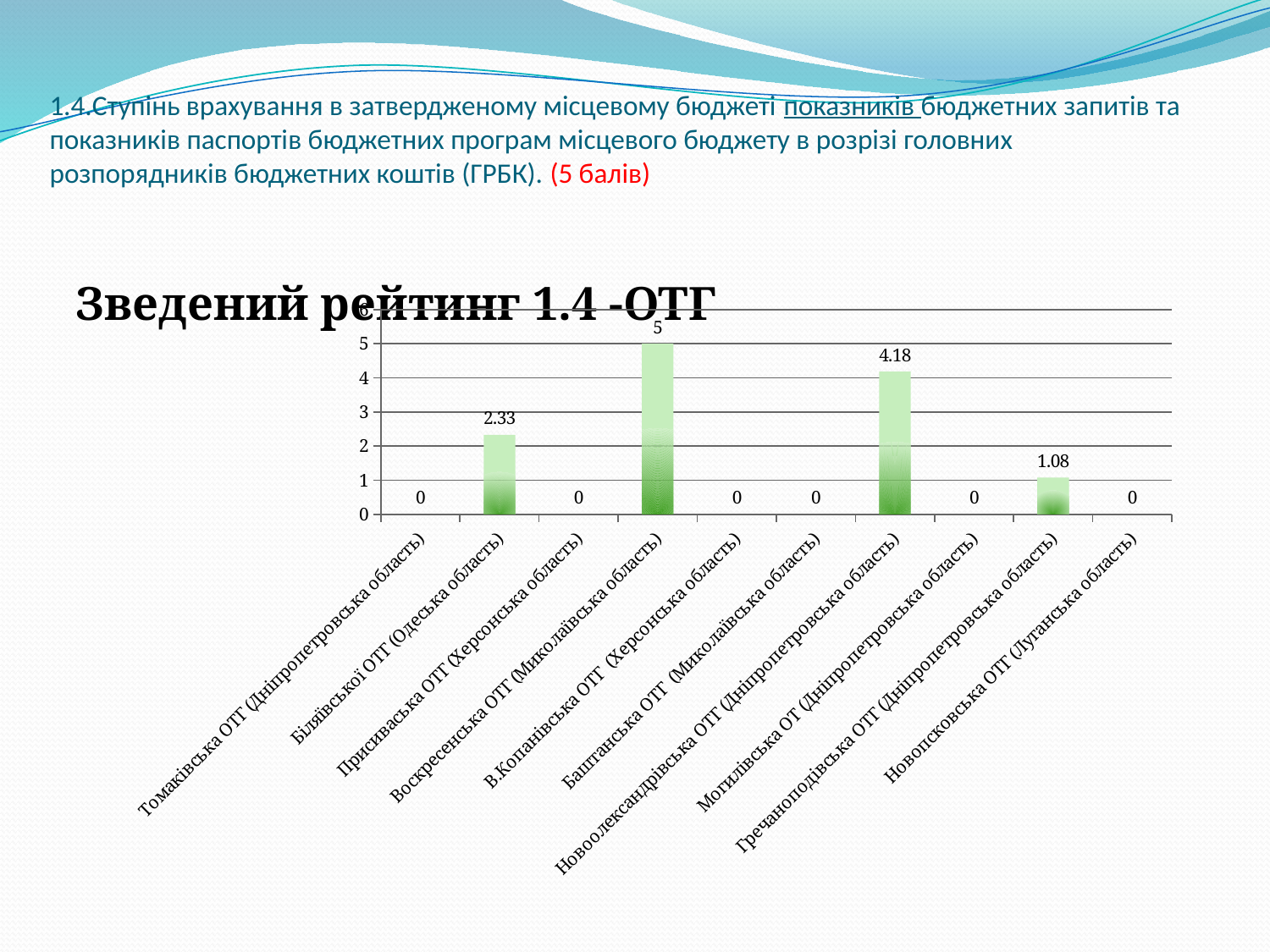
Which category has the highest value on the chart? Воскресенська ОТГ (Миколаївська область) What is the difference between the values for Воскресенська ОТГ and Новоолександрівська ОТГ? 0.82 What is the value for Біляївської ОТГ (Одеська область)? 2.33 What type of chart is shown on the slide? bar chart How many categories (ОТГ) are plotted on the chart? 10 What is the title of the chart? Зведений рейтинг 1.4 -ОТГ How many categories on the chart have a value of 0? 6 What is the value for Томаківська ОТГ (Дніпропетровська область)? 0 Which is larger, the value for Біляївської ОТГ or the value for Гречанопідівська ОТГ? Біляївської ОТГ What is the value for Новоолександрівська ОТГ (Дніпропетровська область)? 4.18 What is the value for Гречанопідівська ОТГ (Дніпропетровська область)? 1.08 What is the value for Воскресенська ОТГ (Миколаївська область)? 5